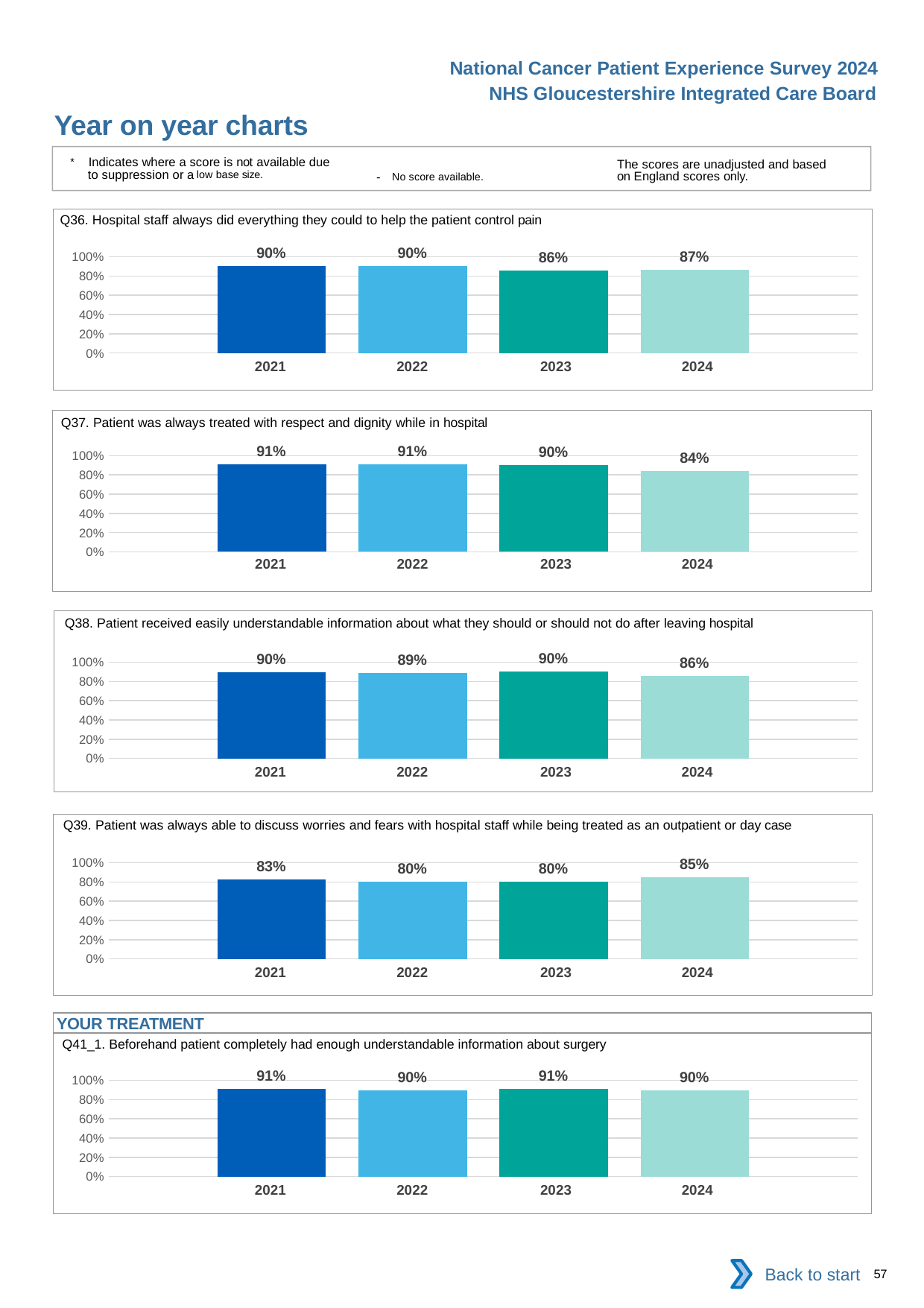
How many years are shown on the x axis of the Q36 chart (hospital staff always did everything they could to help the patient control pain)? 4 In the Q39 chart (patient was always able to discuss worries and fears with hospital staff as an outpatient or day case), is the value for 2021 larger or smaller than the value for 2022? larger In the Q37 chart (patient was always treated with respect and dignity while in hospital), do the values rise or fall from 2021 to 2024? Fall In the Q41_1 chart (beforehand patient completely had enough understandable information about surgery), what is the value for 2024? 90% In the Q37 chart (patient was always treated with respect and dignity while in hospital), what is the difference between the 2023 and 2024 values? 6 percentage points In the Q37 chart (patient was always treated with respect and dignity while in hospital), which year has the lowest value? 2024 In the Q41_1 chart (beforehand patient completely had enough understandable information about surgery), what is the difference between the 2021 and 2022 values? 1 percentage point In the Q38 chart (patient received easily understandable information about what to do after leaving hospital), what is the value for 2022? 89% In the Q36 chart (hospital staff always did everything they could to help the patient control pain), what is the value for 2023? 86% What type of chart is the Q38 chart (patient received easily understandable information about what to do after leaving hospital)? Bar chart What is the section heading printed above the Q41_1 chart? YOUR TREATMENT In the Q39 chart (patient was always able to discuss worries and fears with hospital staff as an outpatient or day case), which year has the highest value? 2024